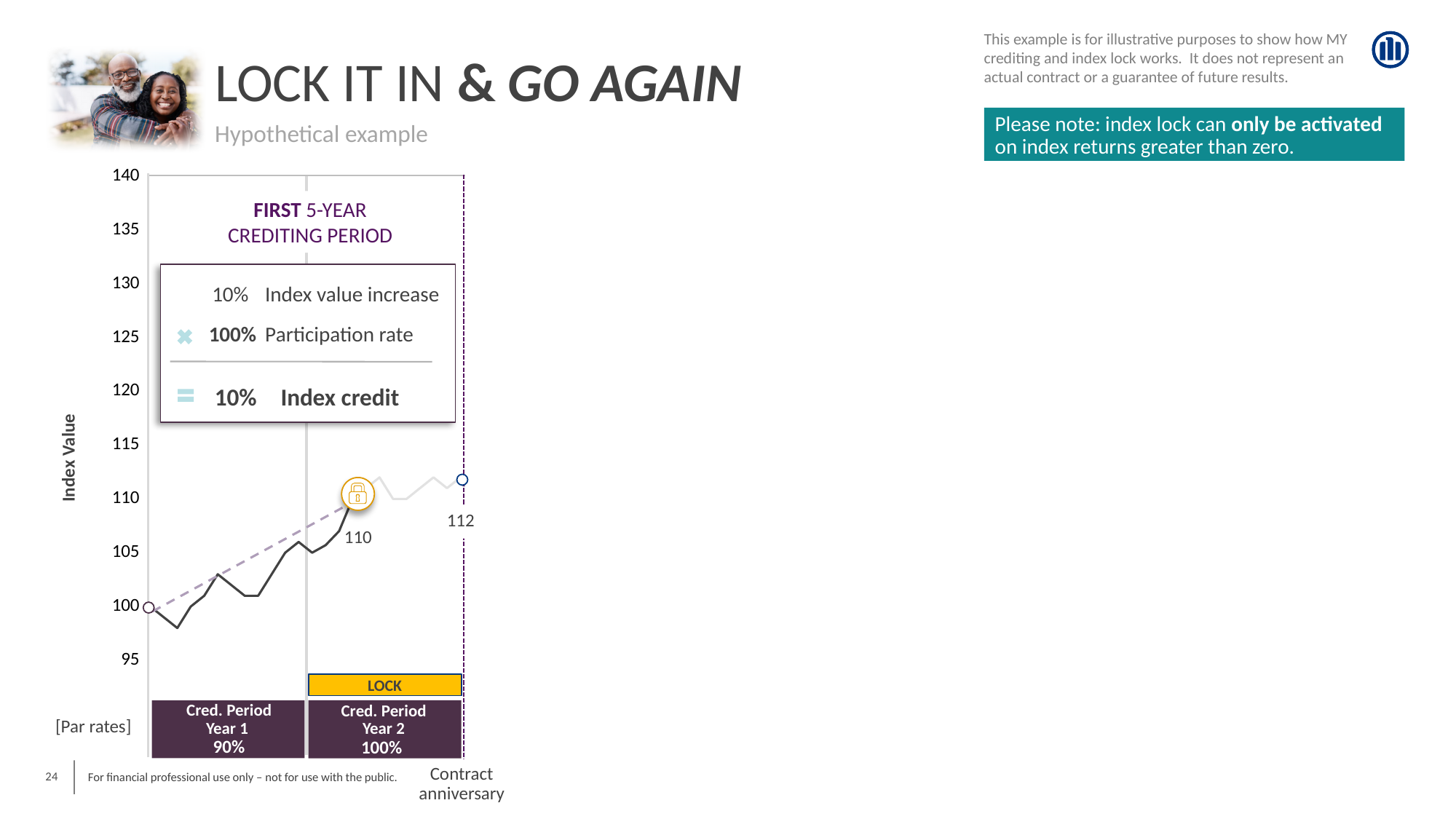
What is the index value at the contract anniversary at the end of the chart? 112 What is the par rate shown for Cred. Period Year 2? 100% Which is larger, the index value at the lock point or the index value at the contract anniversary? contract anniversary (112) What is the index value at the start of the first crediting period? 100 What is the index value at the point where the lock is activated? 110 Is the index value at the contract anniversary greater or less than 115? less Is the lowest point of the index line in Year 1 greater or less than 100? less Overall, does the index value rise or fall from the start of the chart to the contract anniversary? rise By how much did the index value rise from the start (100) to the lock point (110)? 10 What kind of chart is shown on the slide? line chart What is the label on the y-axis of the chart? Index Value What is the difference between the index value at the contract anniversary (112) and the locked value (110)? 2